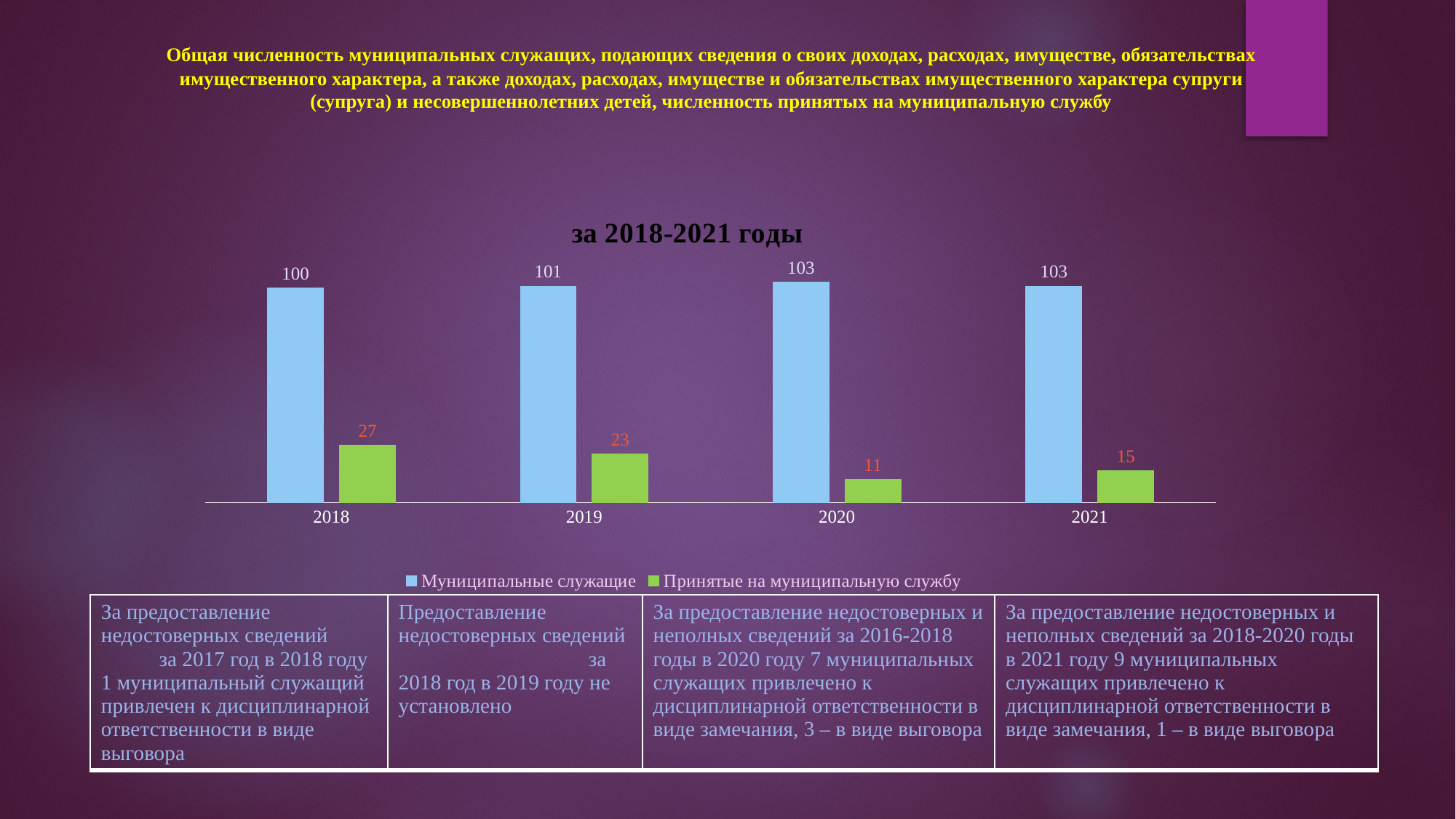
How many years are shown on the x axis of the chart? 4 What is the title of the chart? за 2018-2021 годы What is the difference in Принятые на муниципальную службу between 2018 and 2020? 16 What is the value for Муниципальные служащие in 2018? 100 Which year has the lowest value for Принятые на муниципальную службу? 2020 How many series does the legend list? 2 What is the difference between Муниципальные служащие and Принятые на муниципальную службу in 2019? 78 What is the value for Принятые на муниципальную службу in 2021? 15 What is the value for Принятые на муниципальную службу in 2020? 11 Which year has the highest value for Принятые на муниципальную службу? 2018 Which is larger: Принятые на муниципальную службу in 2019 or in 2021? 2019 What kind of chart is shown on the slide? Bar chart